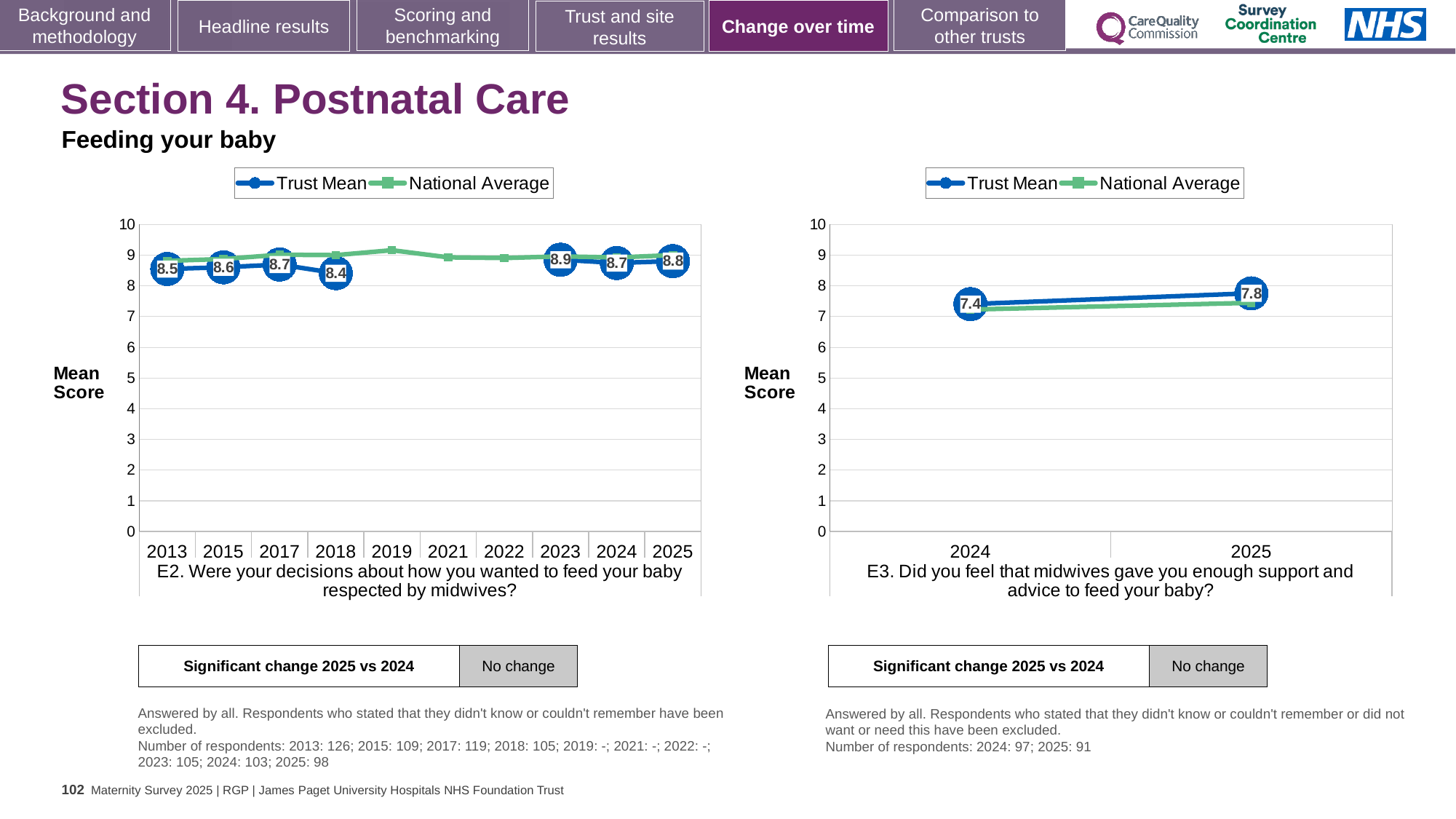
How many years are shown on the x axis of the E2 chart on the left? 10 In the E3 chart on the right, what is the difference between the Trust Mean for 2025 and 2024? 0.4 In the E3 chart on the right, what is the Trust Mean for 2025? 7.8 What kind of chart is the E3 chart on the right? Line chart In the E2 chart on the left, which year has the highest Trust Mean? 2023 In the E2 chart on the left, which year has the lowest Trust Mean? 2018 In the E3 chart on the right, does the Trust Mean rise or fall from 2024 to 2025? Rise In the E2 chart on the left, what is the Trust Mean for 2023? 8.9 In the E2 chart on the left, is the Trust Mean higher in 2013 or 2025? 2025 In the E2 chart on the left, what is the Trust Mean for 2018? 8.4 How many series does the legend of the E3 chart on the right list? 2 In the E2 chart on the left, is the National Average for 2019 greater or less than 8? greater